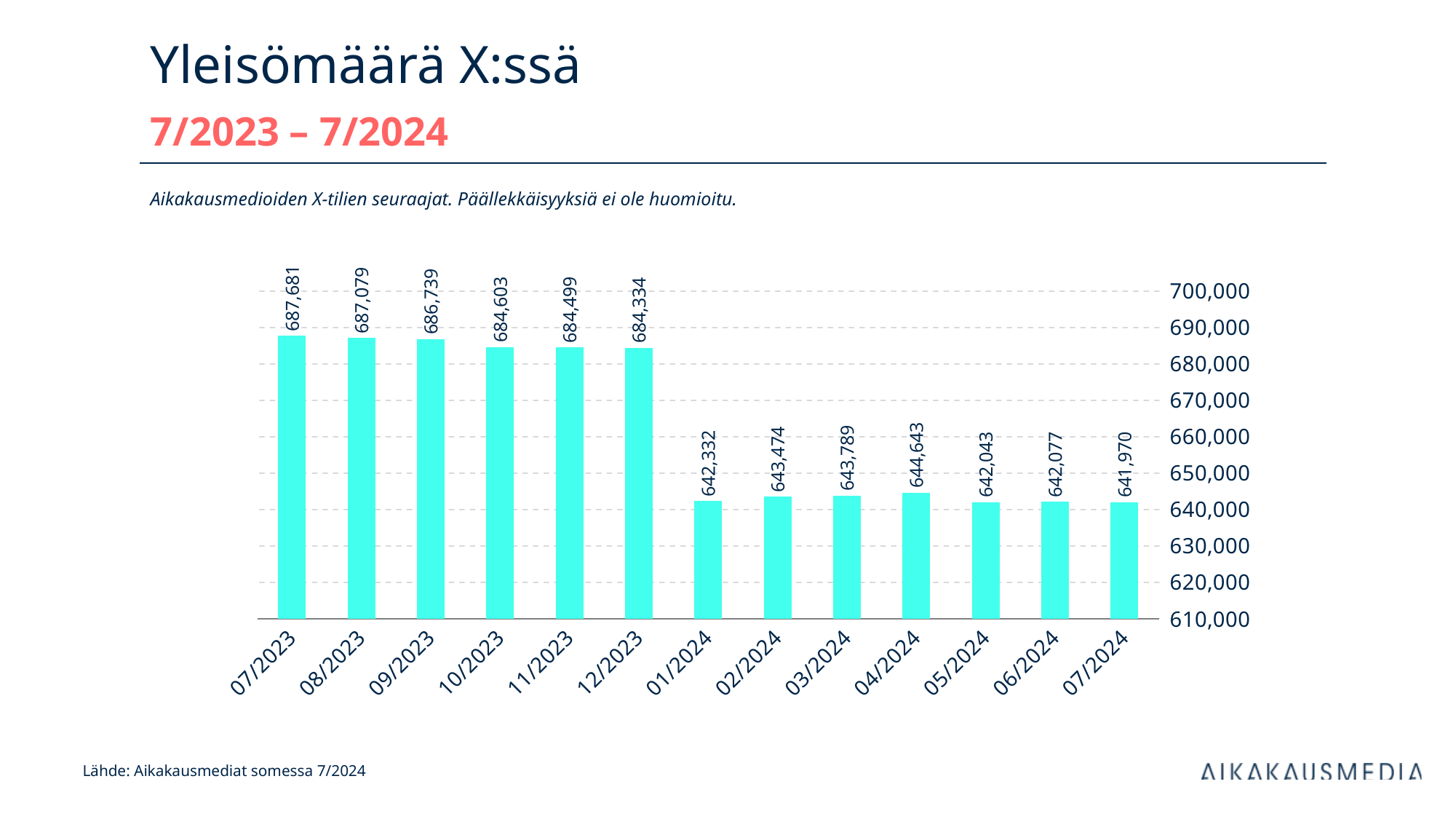
Which month has the highest value? 07/2023 Is the value for 10/2023 greater or less than 680,000? greater Which is larger, the value for 04/2024 or the value for 05/2024? 04/2024 Which month has the lowest value? 07/2024 What is the value for 07/2023? 687,681 How many months are shown on the x axis? 13 What kind of chart is shown on the slide? bar chart Do the values generally rise or fall from 07/2023 to 07/2024? fall What is the value for 07/2024? 641,970 What is the difference between the values for 12/2023 and 01/2024? 42,002 What is the difference between the values for 07/2023 and 07/2024? 45,711 What is the value for 01/2024? 642,332